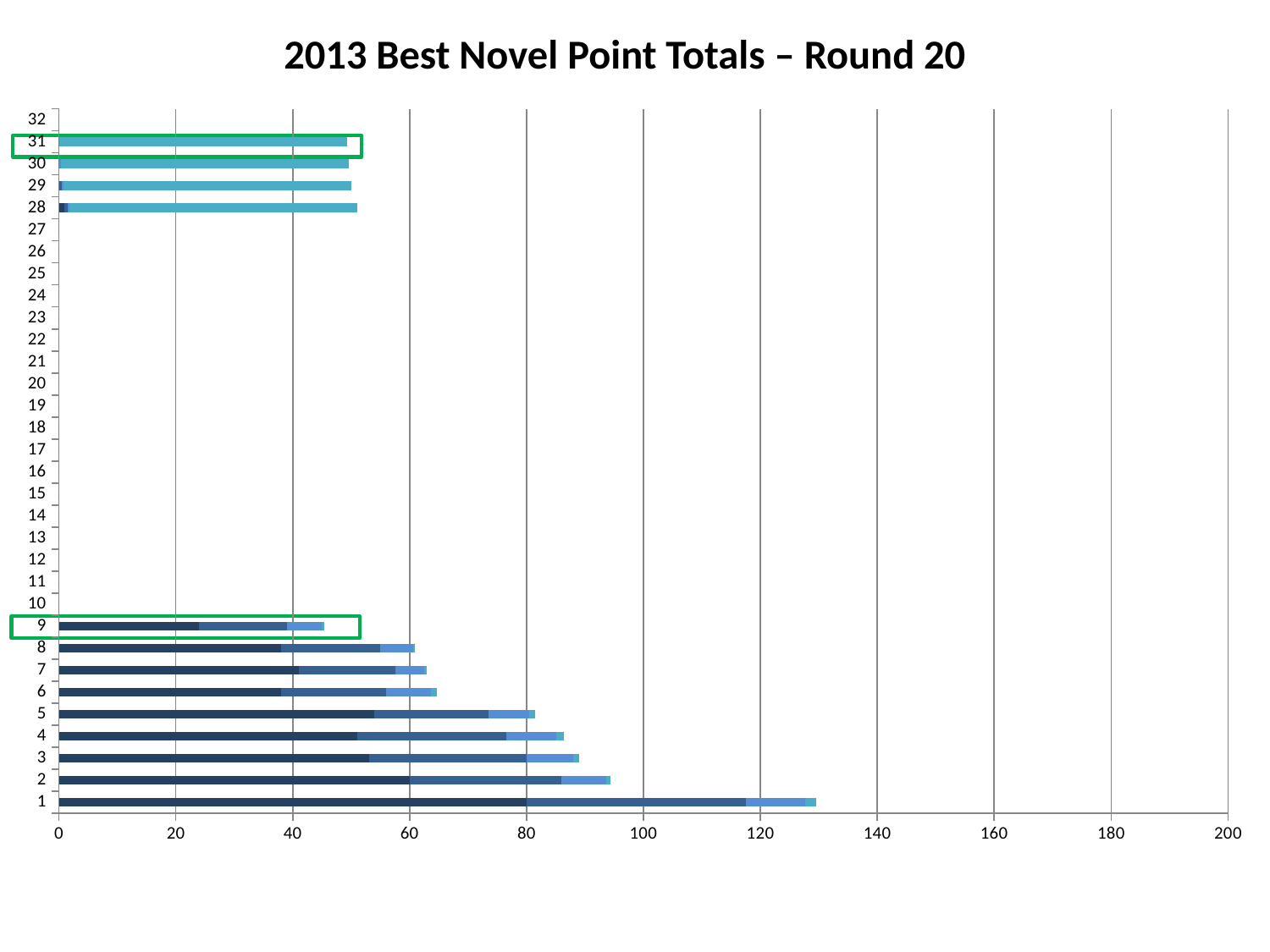
Is the total for category 9 greater or less than 40? greater Is the total for category 28 greater or less than 60? less Which has the larger total, category 8 or category 9? 8 What is the title of the chart? 2013 Best Novel Point Totals – Round 20 Which category has the highest total? 1 Is the total for category 2 greater or less than 100? less Among categories 1 through 9, which has the lowest total? 9 How many categories are labelled on the vertical axis? 32 Which two categories are highlighted with green boxes? 9 and 31 How many categories have a visible bar plotted? 13 What kind of chart is shown on the slide? bar chart